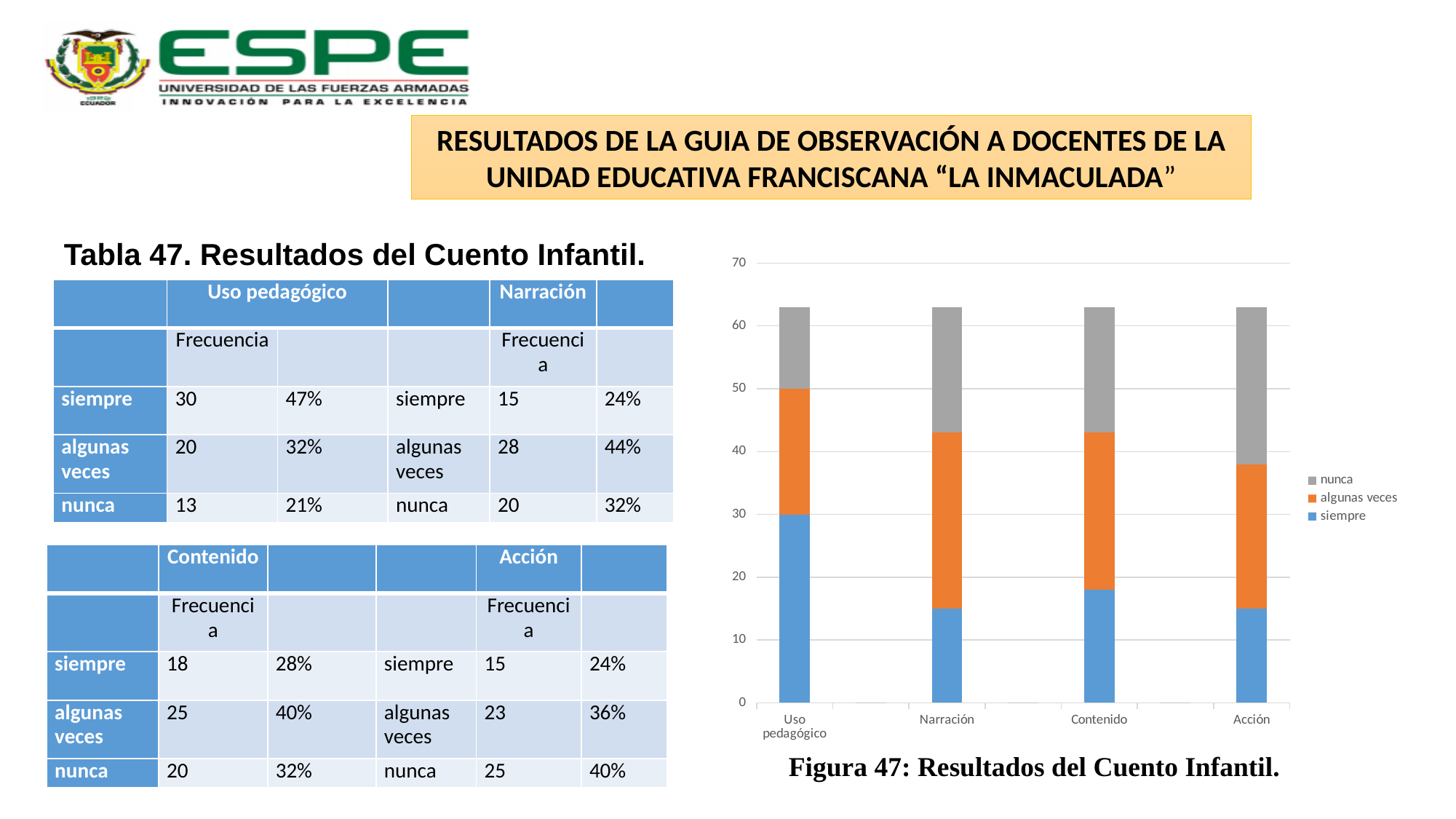
How many series does the legend of Figura 47 list? 3 In Figura 47, which category has the tallest 'siempre' segment? Uso pedagógico In Figura 47, is the total height of the Contenido bar greater or less than 60? greater How many categories are shown on the x axis of Figura 47? 4 In Figura 47, what is the total of the stacked bar for Uso pedagógico (siempre 30, algunas veces 20, nunca 13)? 63 What is the caption of the chart on the slide? Figura 47: Resultados del Cuento Infantil. In Figura 47, is the 'siempre' segment larger for Uso pedagógico or for Acción? Uso pedagógico In Figura 47, which colour represents the 'algunas veces' series? orange In Figura 47, what is the value of the 'siempre' segment for Uso pedagógico? 30 In Figura 47, is the 'siempre' segment for Narración greater or less than 20? less What kind of chart is shown in Figura 47? bar chart In Figura 47, is the 'nunca' segment larger for Acción or for Uso pedagógico? Acción